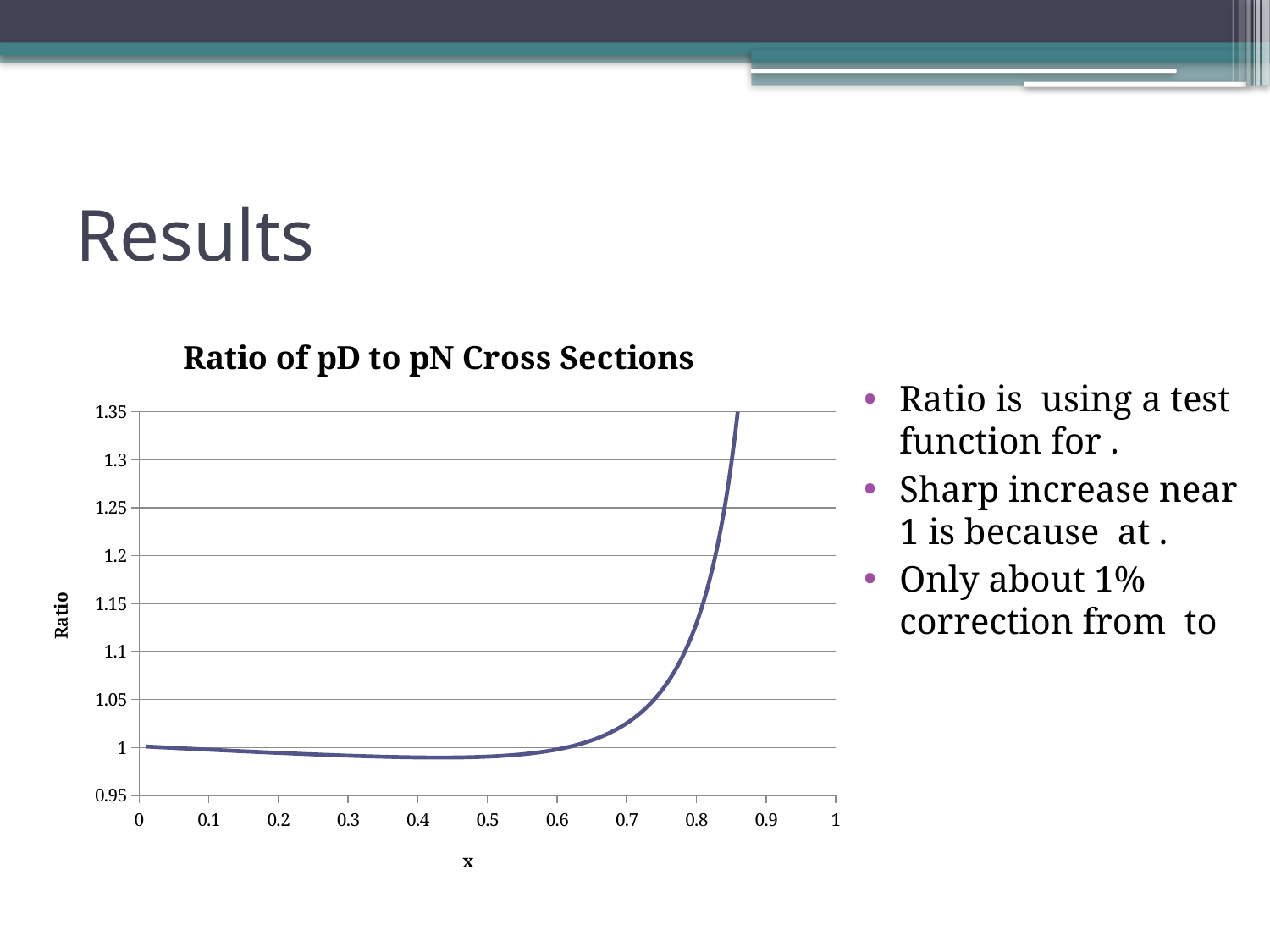
Which of the two x values, 0.5 or 0.8, has the larger ratio? 0.8 What is the label of the vertical axis of the chart? Ratio Does the ratio rise or fall as x increases from 0 to 0.4? fall Does the ratio rise or fall as x increases from 0.6 to 0.85? rise Is the value of the ratio at x = 0.7 greater or less than 1.05? less What is the title of the chart? Ratio of pD to pN Cross Sections What kind of chart is shown on the slide? line chart Is the value of the ratio at x = 0.2 greater or less than 1.05? less What is the lowest value shown on the vertical axis of the chart? 0.95 How many tick labels are shown on the x axis of the chart? 11 Is the value of the ratio at x = 0.4 greater or less than 1? less